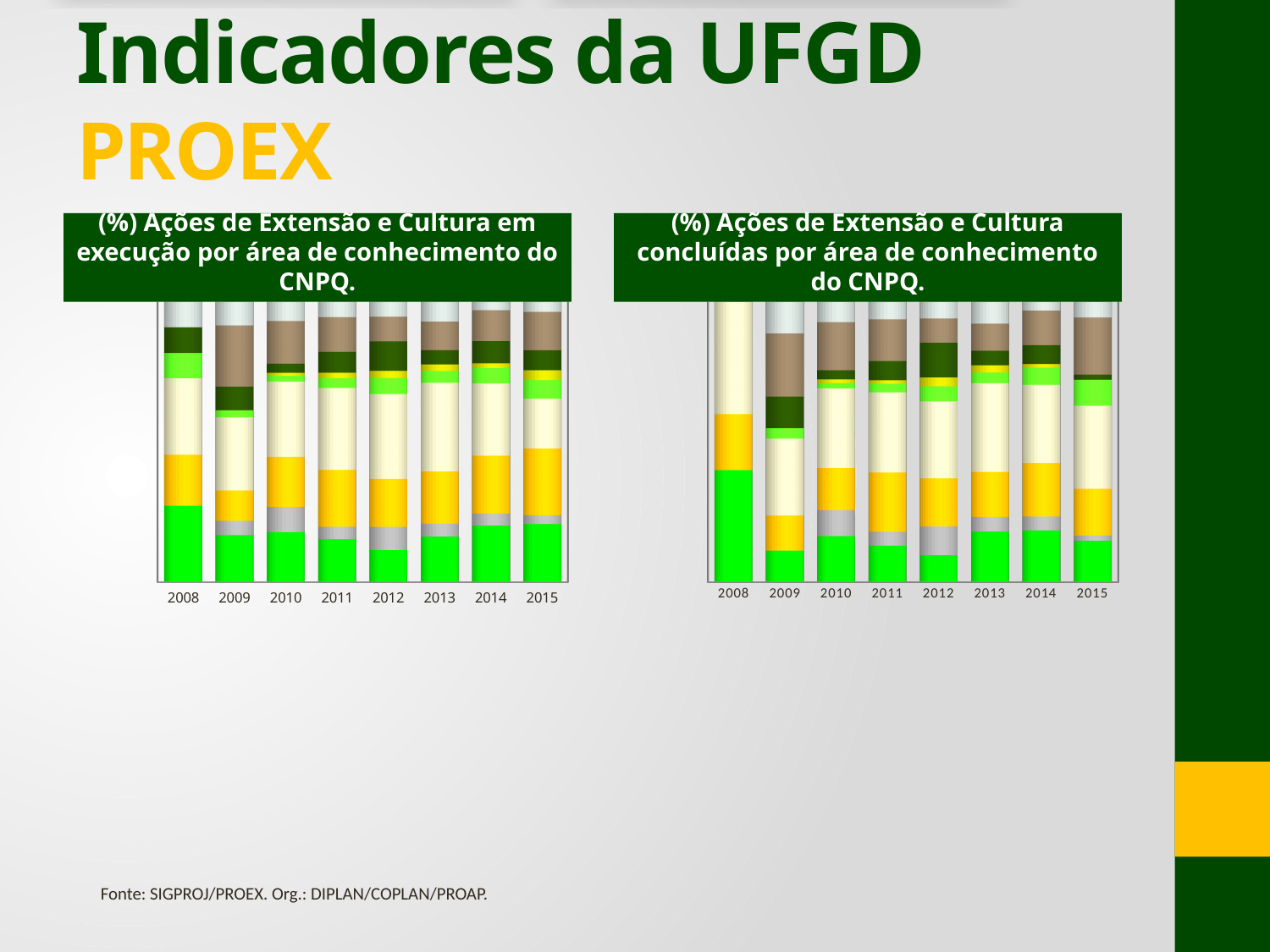
In the left chart, how many years are shown on the x axis? 8 What type of chart is the right chart, titled "(%) Ações de Extensão e Cultura concluídas por área de conhecimento do CNPQ."? Stacked bar chart What type of chart is the left chart, titled "(%) Ações de Extensão e Cultura em execução por área de conhecimento do CNPQ."? Stacked bar chart In the right chart, is the bottom bright-green segment larger for 2008 or for 2009? 2008 What is the first year shown on the x axis of the left chart? 2008 What is the last year shown on the x axis of the right chart? 2015 In the left chart, is the bottom bright-green segment larger for 2008 or for 2012? 2008 In the left chart, which year has the smallest bottom bright-green segment? 2012 In the right chart, which year has the largest bottom bright-green segment? 2008 In the right chart, how many bars are plotted? 8